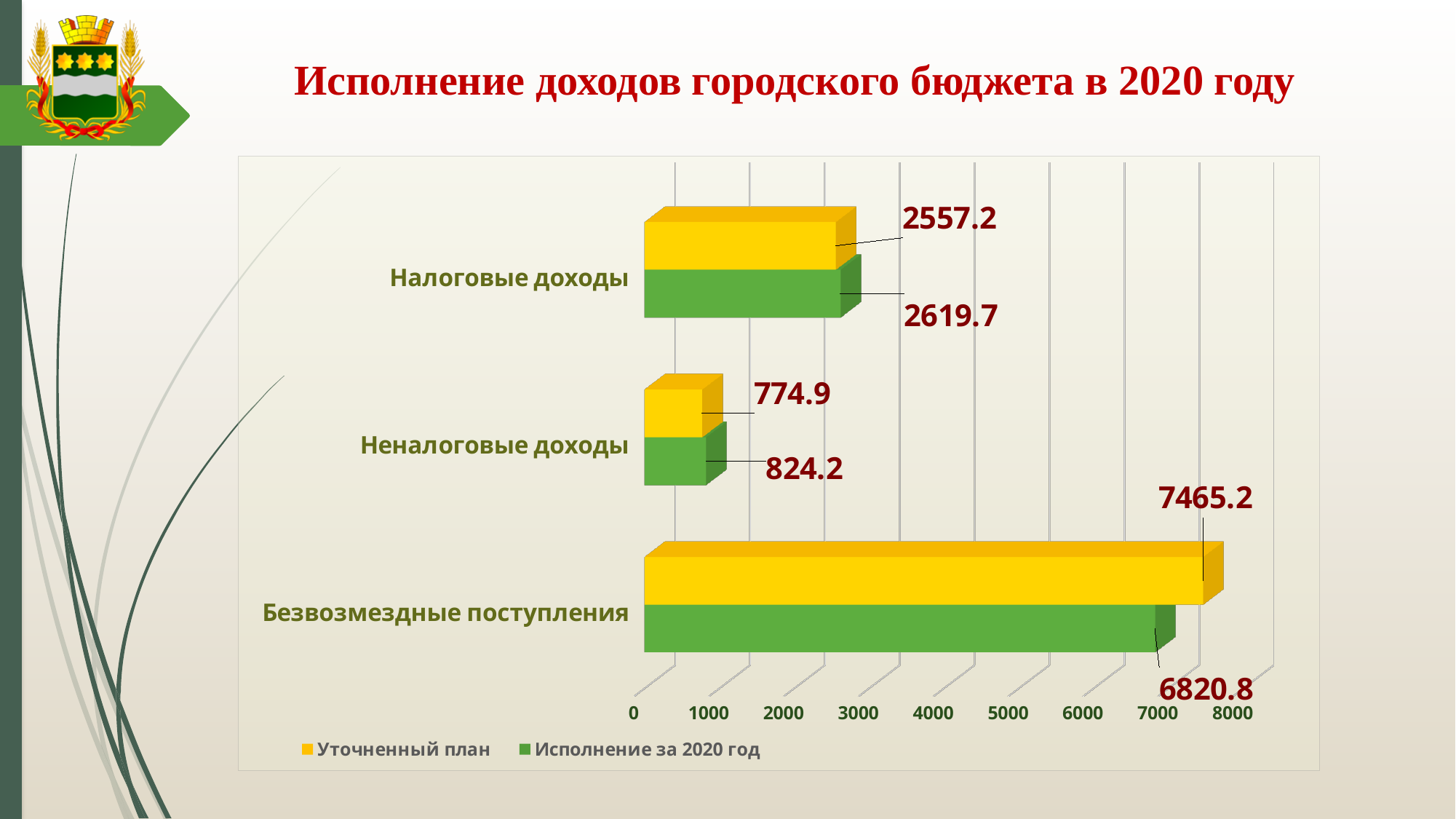
Which category has the lowest 'Исполнение за 2020 год' value? Неналоговые доходы Which category has the highest 'Уточненный план' value? Безвозмездные поступления What is the difference between 'Уточненный план' and 'Исполнение за 2020 год' for 'Безвозмездные поступления'? 644.4 What type of chart is shown on the slide? Bar chart What is the difference between 'Исполнение за 2020 год' and 'Уточненный план' for 'Налоговые доходы'? 62.5 What is the value of 'Исполнение за 2020 год' for 'Неналоговые доходы'? 824.2 For 'Неналоговые доходы', which is larger: 'Уточненный план' or 'Исполнение за 2020 год'? Исполнение за 2020 год What is the value of 'Исполнение за 2020 год' for 'Безвозмездные поступления'? 6820.8 What is the value of 'Уточненный план' for 'Налоговые доходы'? 2557.2 What is the value of 'Уточненный план' for 'Безвозмездные поступления'? 7465.2 How many series does the legend list? 2 How many categories are shown on the chart? 3